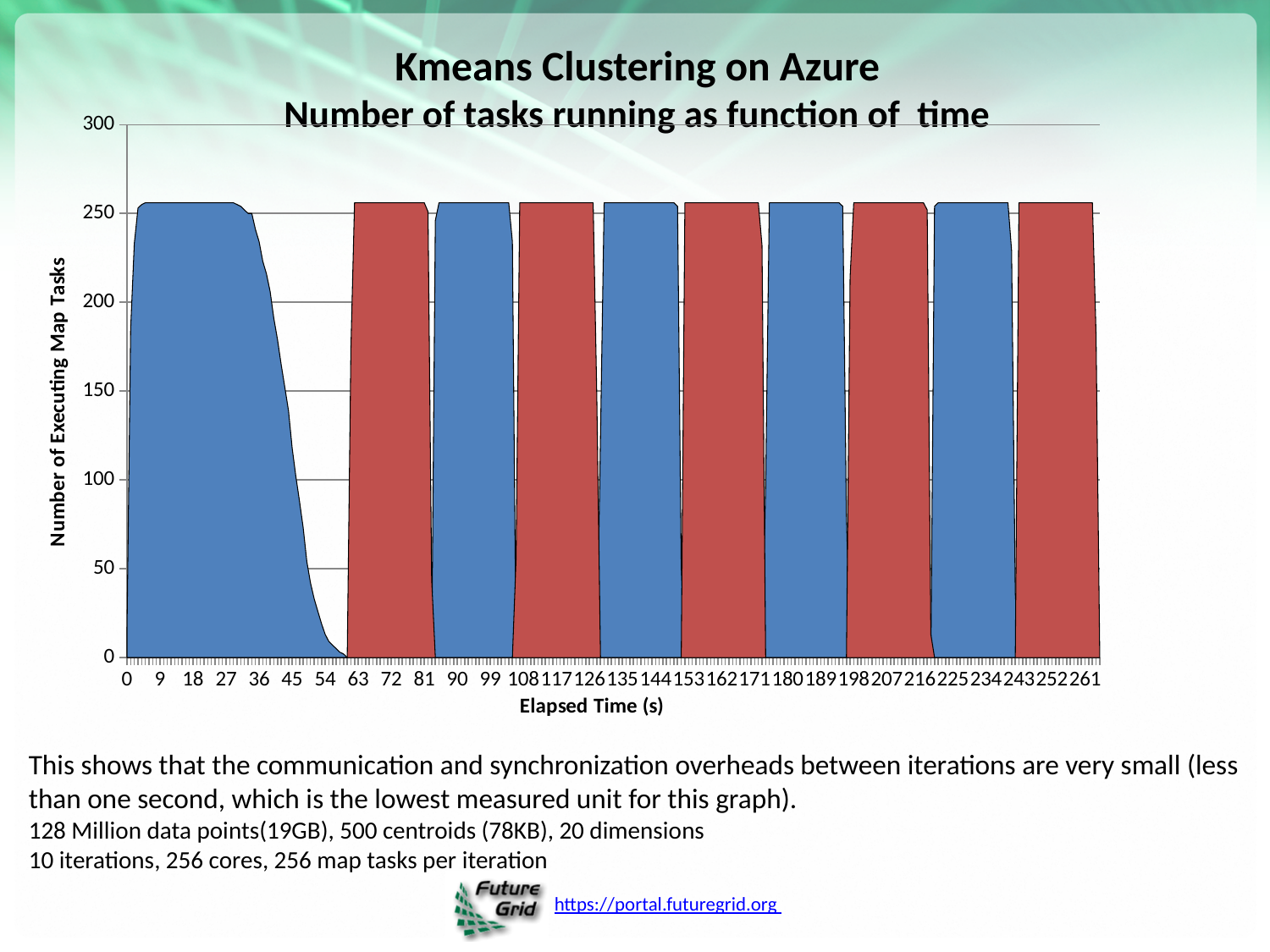
What is the label of the y axis? Number of Executing Map Tasks What is the last tick label on the x axis? 261 Is the number of executing map tasks at 54 s greater or less than 50? less Between 36 s and 54 s, does the number of executing map tasks rise or fall? fall Is the number of executing map tasks at 252 s greater or less than 200? greater Is the number of executing map tasks at 72 s greater or less than 200? greater What is the title of the chart? Kmeans Clustering on Azure Number of tasks running as function of time How many separate filled blocks (iterations) are plotted along the x axis? 10 What kind of chart is shown on the slide? area chart What is the highest value shown on the y axis? 300